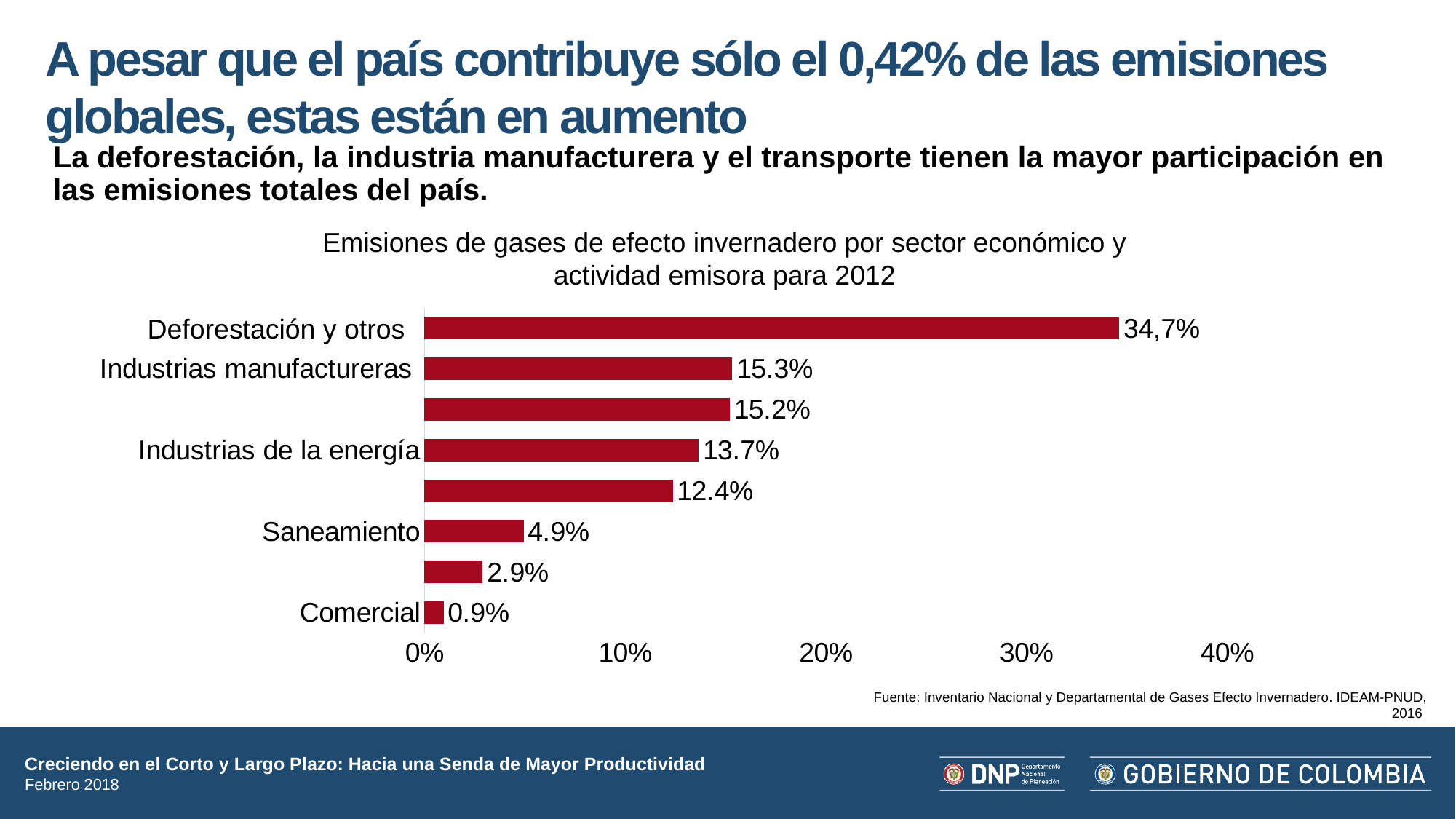
What is the value for Comercial? 0.9% Which category has the lowest value? Comercial Which is larger, the value for Industrias manufactureras or the value for Industrias de la energía? Industrias manufactureras What is the difference between the values for Industrias de la energía and Saneamiento? 8.8% What type of chart is shown on the slide? bar chart How many bars are plotted in the chart? 8 What is the value for Saneamiento? 4.9% What is the value for Industrias de la energía? 13.7% Which category has the highest value? Deforestación y otros Is the value for Saneamiento greater or less than 10%? less What is the value for Deforestación y otros? 34,7% What is the value for Industrias manufactureras? 15.3%